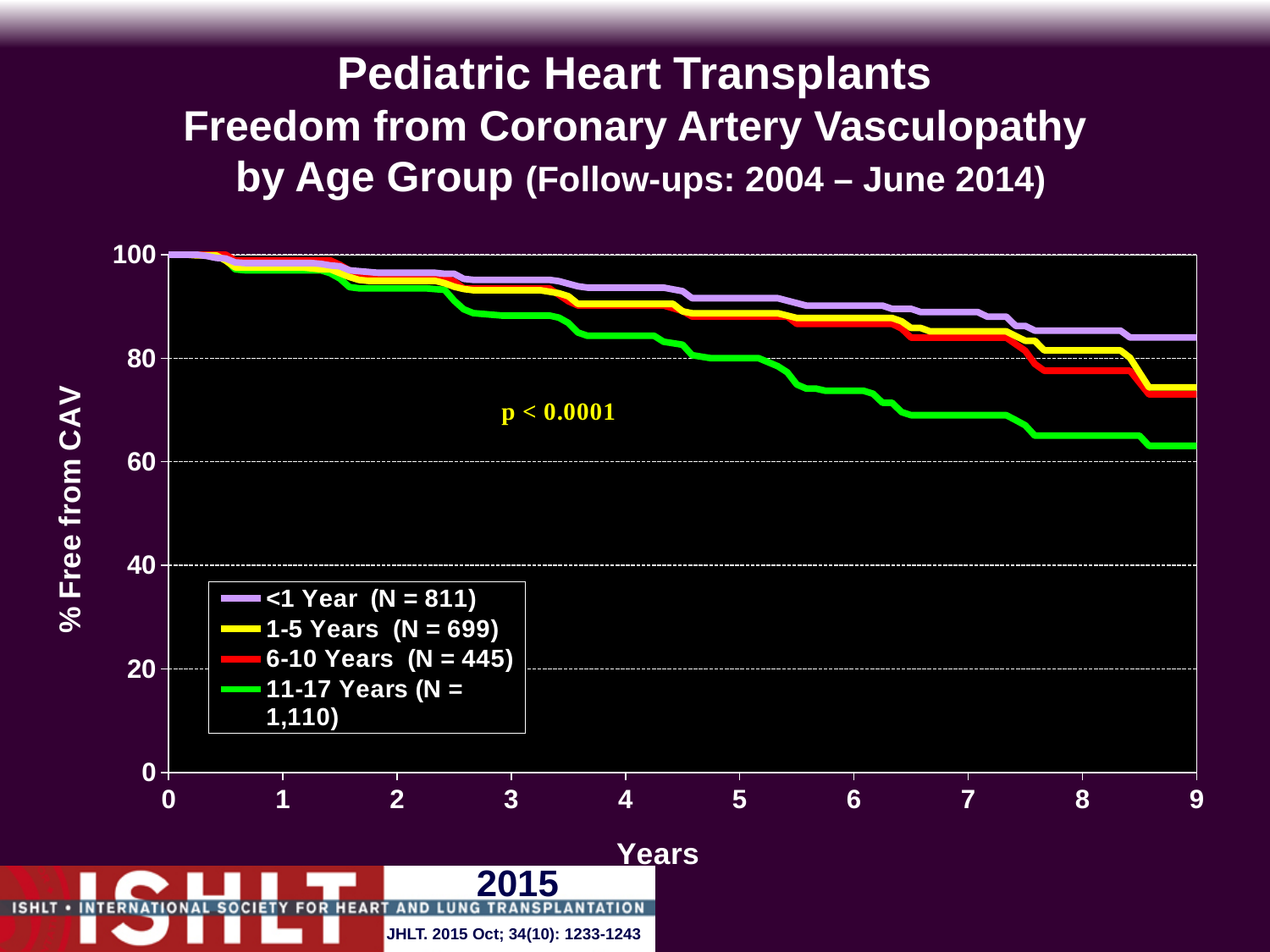
Is the value for 11-17 Years at year 9 greater or less than 60? greater Which age group has the lowest freedom from CAV at year 9? 11-17 Years What is the N for the 11-17 Years group shown in the legend? 1,110 Do the values for each age group rise or fall as years increase? fall Which age group has the highest freedom from CAV at year 9? <1 Year At year 7, which is larger: the value for 1-5 Years or the value for 11-17 Years? 1-5 Years Is the value for <1 Year at year 9 greater or less than 80? greater Is the value for 11-17 Years at year 9 greater or less than 80? less What kind of chart is shown on the slide? line chart How many series does the legend list? 4